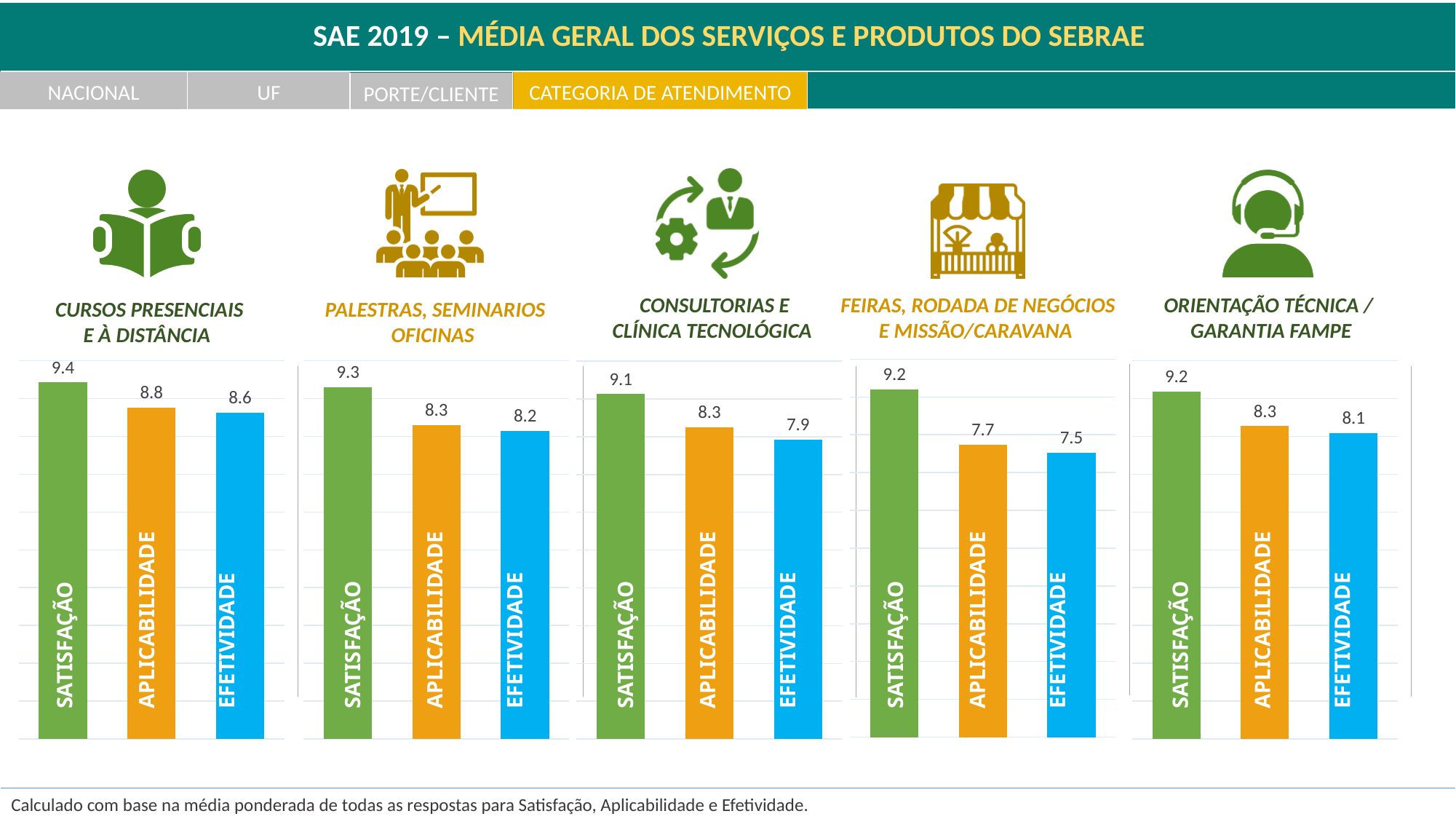
In the 'Palestras, Seminarios Oficinas' chart, what is the difference between Satisfação and Aplicabilidade? 1.0 In the 'Cursos Presenciais e à Distância' chart, which category has the highest value? Satisfação How many bars does the 'Orientação Técnica / Garantia Fampe' chart have? 3 In the 'Cursos Presenciais e à Distância' chart, what is the value for Satisfação? 9.4 In the 'Feiras, Rodada de Negócios e Missão/Caravana' chart, which category has the lowest value? Efetividade Which is larger: Aplicabilidade in the 'Cursos Presenciais e à Distância' chart or Aplicabilidade in the 'Feiras, Rodada de Negócios e Missão/Caravana' chart? Cursos Presenciais e à Distância In the 'Consultorias e Clínica Tecnológica' chart, what is the value for Aplicabilidade? 8.3 In the 'Palestras, Seminarios Oficinas' chart, what is the value for Efetividade? 8.2 What type of chart is used for 'Consultorias e Clínica Tecnológica'? Bar chart In the 'Orientação Técnica / Garantia Fampe' chart, what is the value for Satisfação? 9.2 In the 'Consultorias e Clínica Tecnológica' chart, what is the difference between Satisfação and Efetividade? 1.2 In the 'Feiras, Rodada de Negócios e Missão/Caravana' chart, what is the value for Efetividade? 7.5